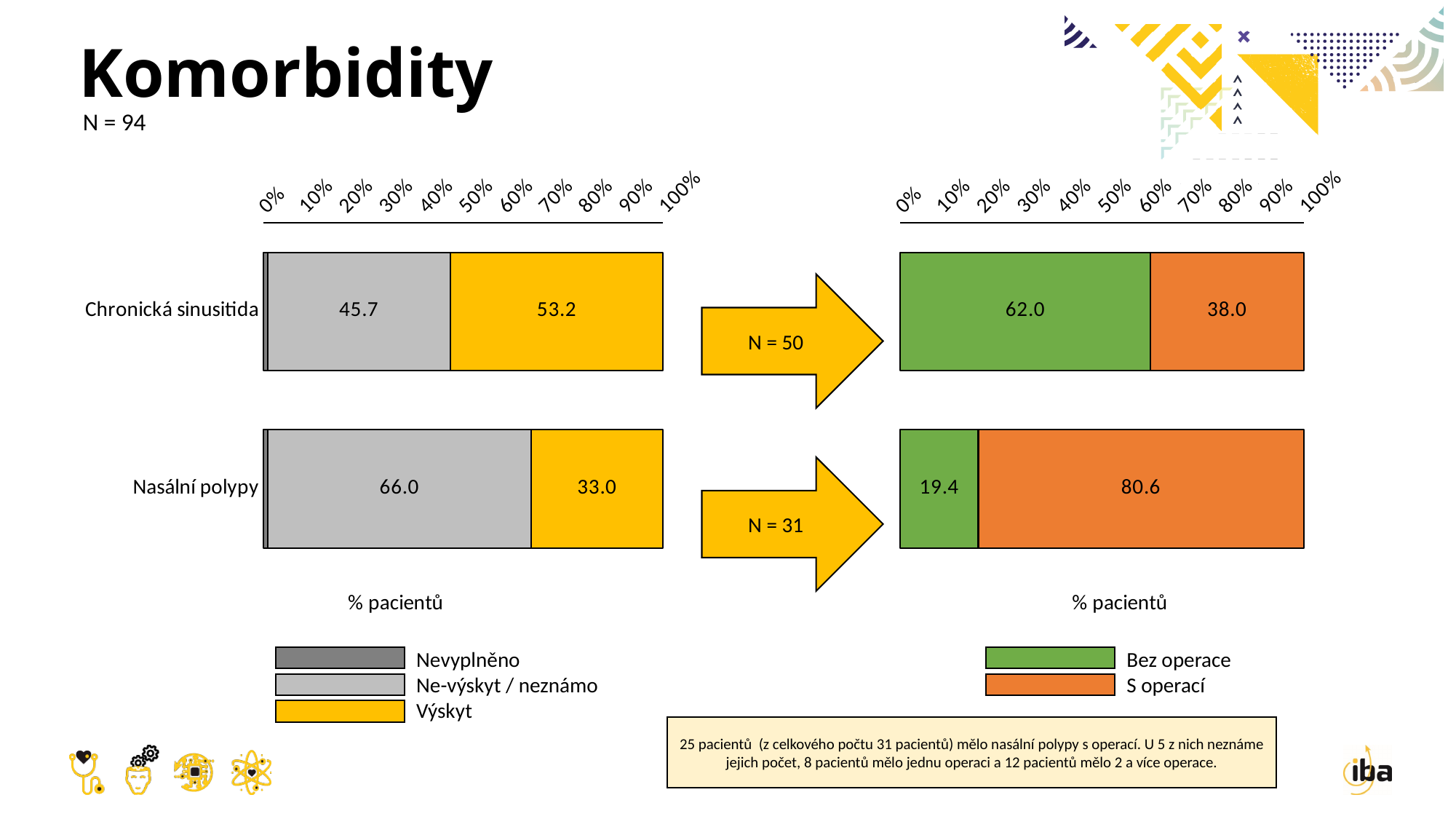
In the right chart, what is the Bez operace value for Chronická sinusitida? 62.0 In the right chart, what is the difference between the S operací and Bez operace values for Nasální polypy? 61.2 In the left chart, is the Nevyplněno value for Chronická sinusitida greater or less than 10%? less In the left chart, what is the Výskyt value for Chronická sinusitida? 53.2 In the left chart, what is the Ne-výskyt / neznámo value for Nasální polypy? 66.0 In the right chart, what is the S operací value for Nasální polypy? 80.6 How many categories are shown in the right chart? 2 In the left chart, which category has the higher Výskyt value? Chronická sinusitida How many series does the legend of the left chart list? 3 In the left chart, what is the difference between the Výskyt values for Chronická sinusitida and Nasální polypy? 20.2 In the right chart, which category has the larger Bez operace value, Chronická sinusitida or Nasální polypy? Chronická sinusitida What kind of chart is the right chart? stacked bar chart